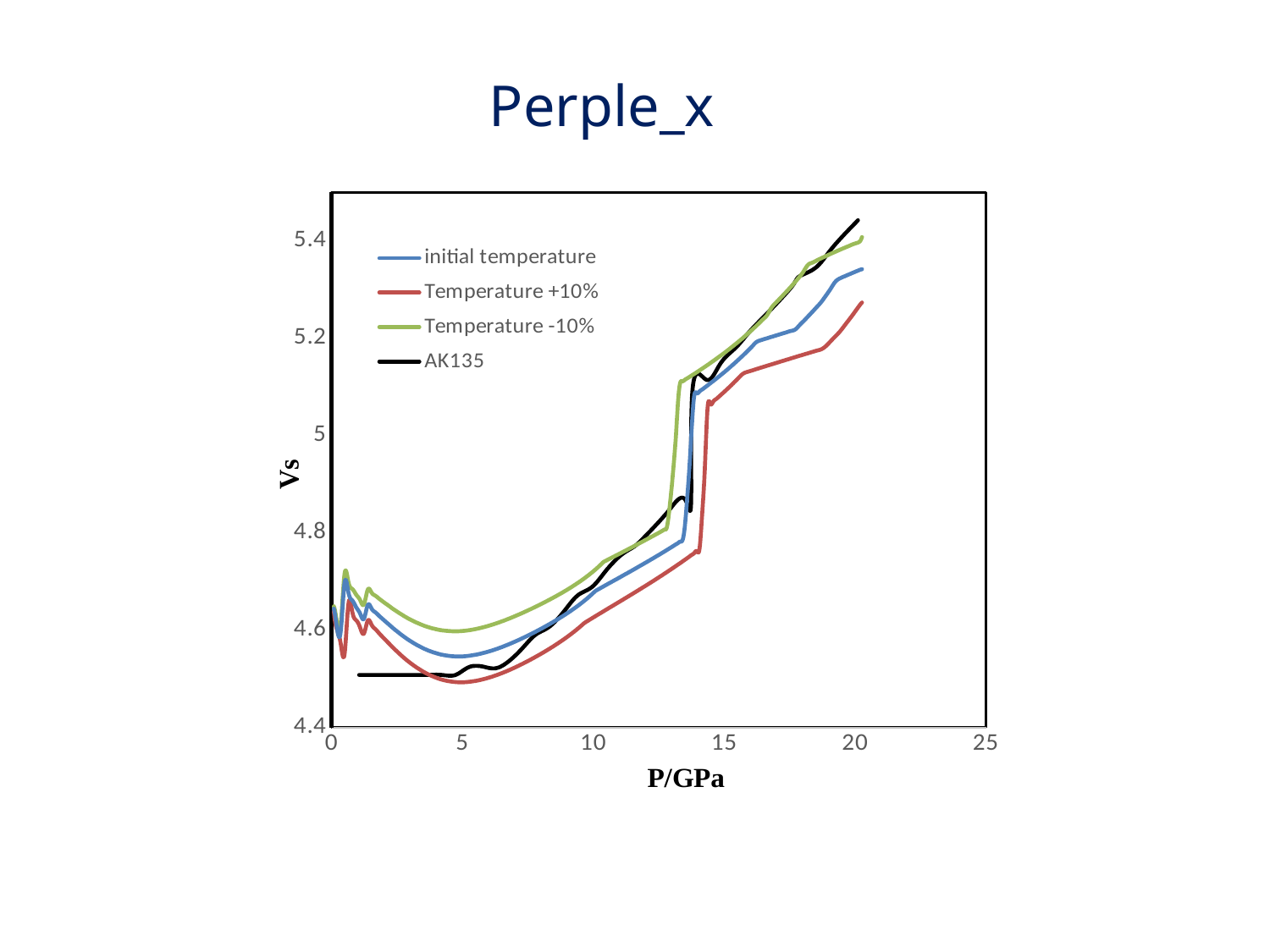
Is the Vs value for initial temperature at 15 GPa greater or less than 5? greater At 20 GPa, which series has the higher Vs: Temperature +10% or Temperature -10%? Temperature -10% How many series does the legend list? 4 What is the label of the x axis? P/GPa At 10 GPa, which series has the higher Vs: initial temperature or Temperature +10%? initial temperature What is the title of the chart? Perple_x Is the Vs value for AK135 at 5 GPa greater or less than 4.6? less Between 5 and 20 GPa, does the Vs value for the initial temperature series rise or fall as pressure increases? rise Is the Vs value for Temperature +10% at 10 GPa greater or less than 4.8? less At 5 GPa, which series has the lowest Vs? Temperature +10% What kind of chart is shown on the slide? line chart